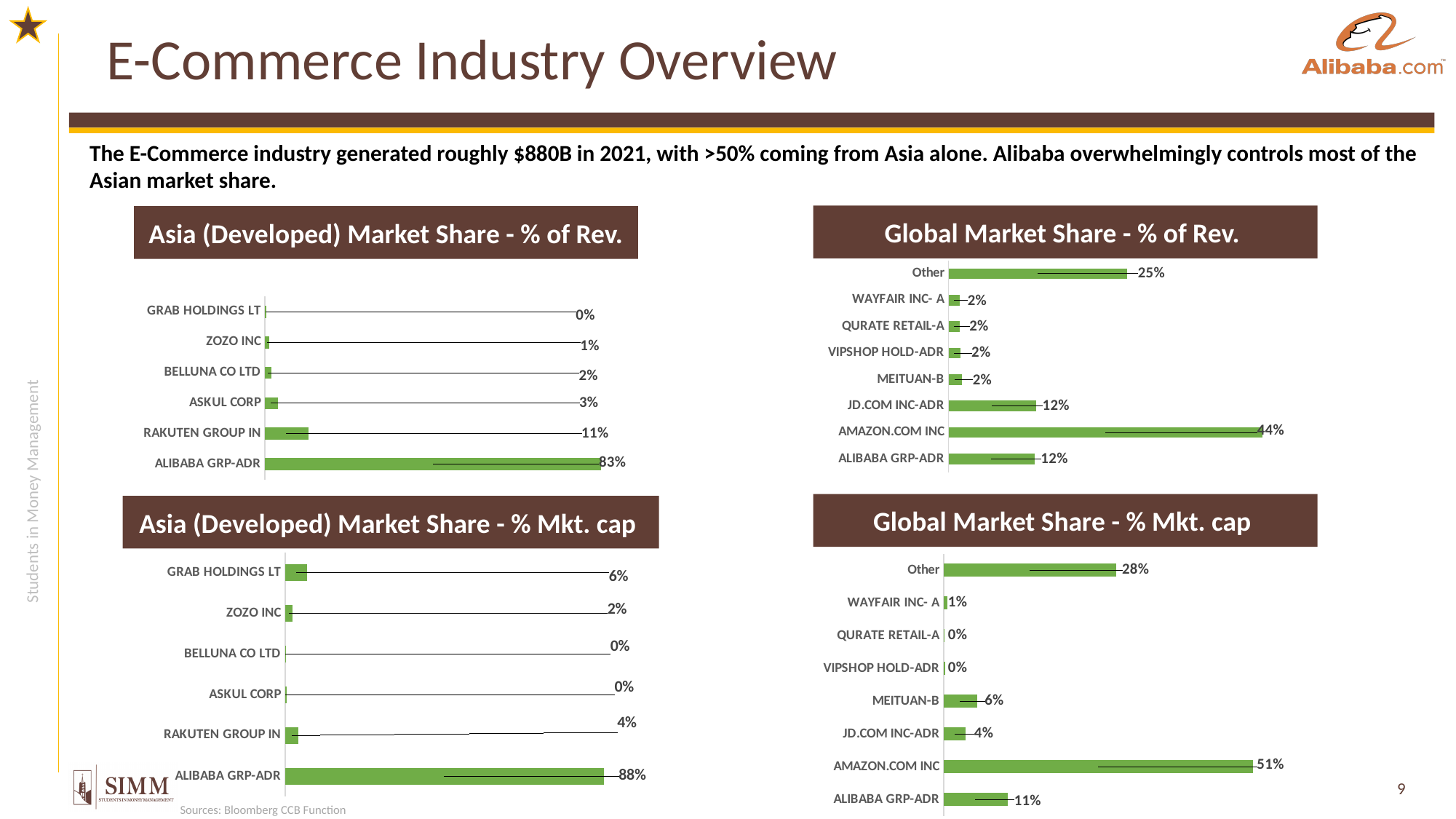
In the 'Asia (Developed) Market Share - % of Rev.' chart, what is the value for RAKUTEN GROUP IN? 11% In the 'Global Market Share - % of Rev.' chart, which company has the highest share? AMAZON.COM INC In the 'Global Market Share - % Mkt. cap' chart, what is the value for AMAZON.COM INC? 51% In the 'Global Market Share - % Mkt. cap' chart, what is the value for Other? 28% In the 'Global Market Share - % of Rev.' chart, what is the value for JD.COM INC-ADR? 12% In the 'Asia (Developed) Market Share - % Mkt. cap' chart, what is the value for GRAB HOLDINGS LT? 6% In the 'Global Market Share - % of Rev.' chart, what is the difference between AMAZON.COM INC and ALIBABA GRP-ADR? 32% In the 'Global Market Share - % Mkt. cap' chart, which is larger, MEITUAN-B or JD.COM INC-ADR? MEITUAN-B What type of chart is the 'Global Market Share - % of Rev.' chart? Bar chart In the 'Asia (Developed) Market Share - % of Rev.' chart, what is the value for ALIBABA GRP-ADR? 83% In the 'Global Market Share - % Mkt. cap' chart, how many categories are shown? 8 In the 'Asia (Developed) Market Share - % Mkt. cap' chart, how many companies are listed? 6